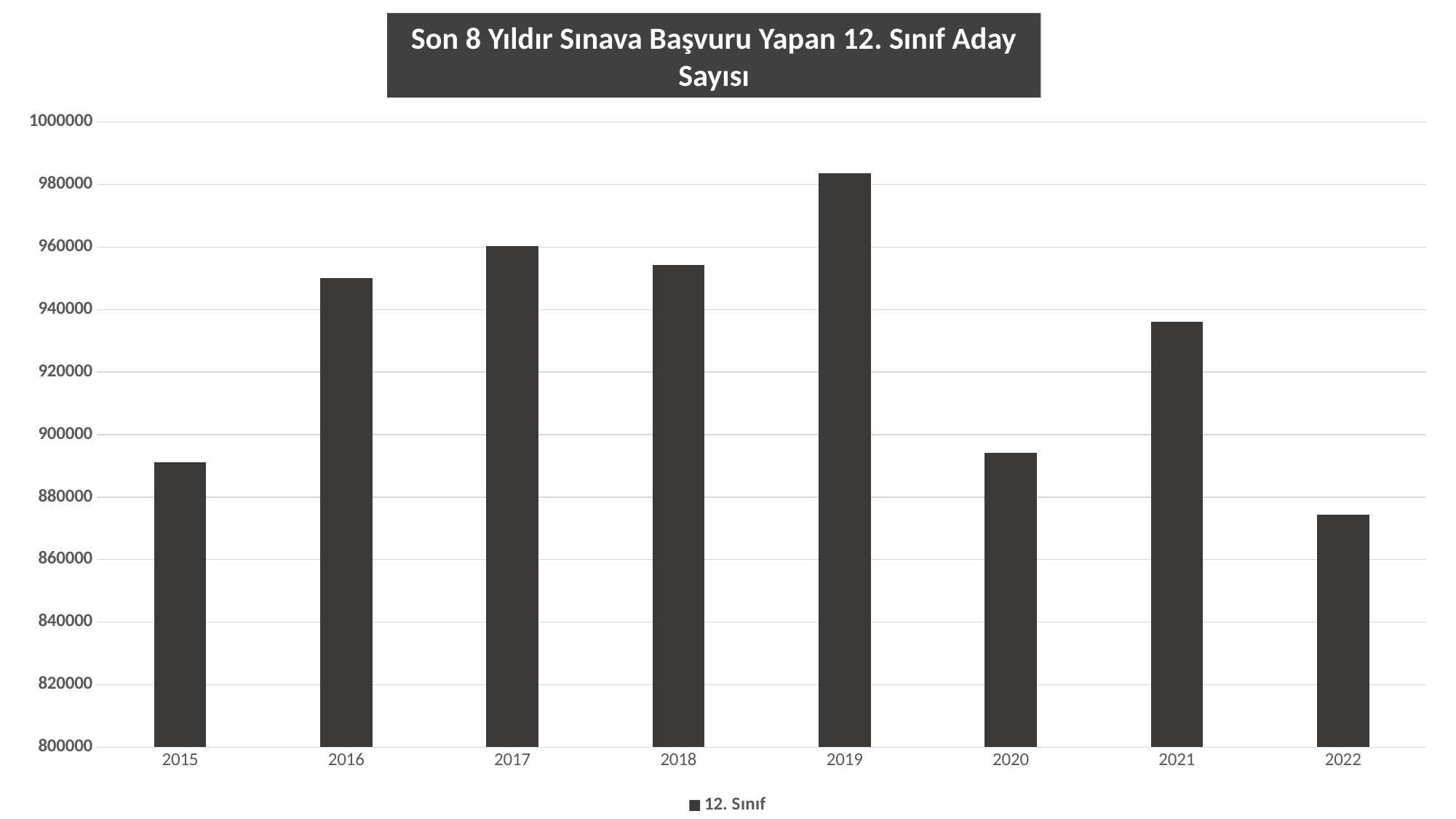
Is the value for 2015 greater or less than 900000? less Which year has the larger value, 2020 or 2021? 2021 Which year has the larger value, 2015 or 2016? 2016 Do the values rise or fall from 2015 to 2017? rise Is the value for 2022 greater or less than 880000? less Is the value for 2019 greater or less than 960000? greater How many years are shown on the x axis of the chart? 8 Which year has the highest number of 12th-grade applicants? 2019 What kind of chart is shown on the slide? bar chart What is the legend entry shown below the chart? 12. Sınıf Which year has the lowest number of 12th-grade applicants? 2022 How many series does the legend list? 1